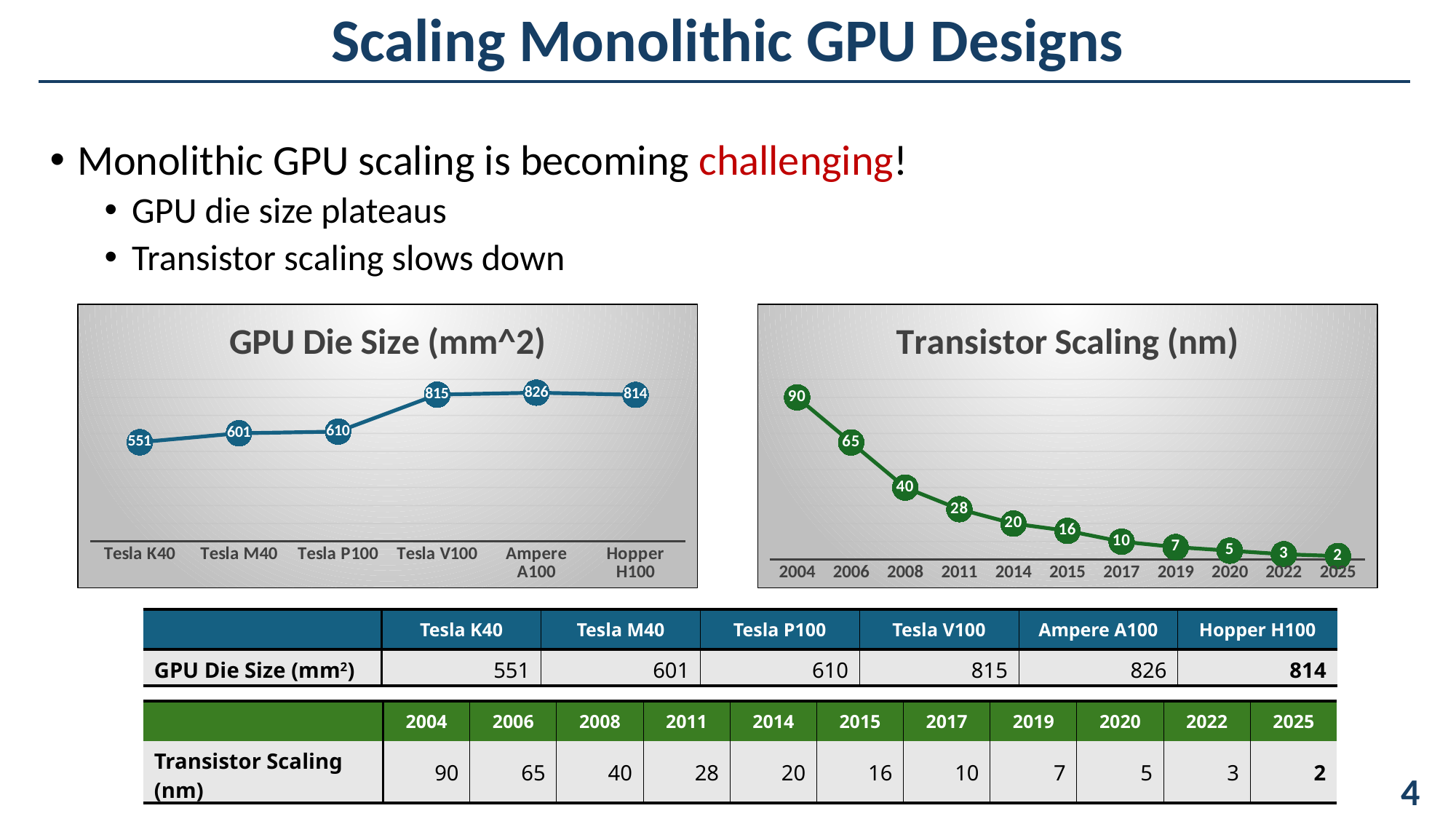
In the GPU Die Size (mm^2) chart, what is the difference between the Tesla V100 and Tesla P100 values? 205 In the Transistor Scaling (nm) chart, which is larger, the value for 2015 or the value for 2017? 2015 In the Transistor Scaling (nm) chart, which year has the lowest value? 2025 In the GPU Die Size (mm^2) chart, which GPU has the smallest die size? Tesla K40 In the Transistor Scaling (nm) chart, what is the value for 2011? 28 In the GPU Die Size (mm^2) chart, how many GPUs are plotted? 6 In the Transistor Scaling (nm) chart, do the values rise or fall from 2004 to 2025? Fall In the GPU Die Size (mm^2) chart, what is the value for Tesla V100? 815 In the Transistor Scaling (nm) chart, how many years are plotted? 11 What kind of chart is the GPU Die Size (mm^2) chart? Line chart In the GPU Die Size (mm^2) chart, which GPU has the largest die size? Ampere A100 In the Transistor Scaling (nm) chart, what is the difference between the 2004 and 2006 values? 25